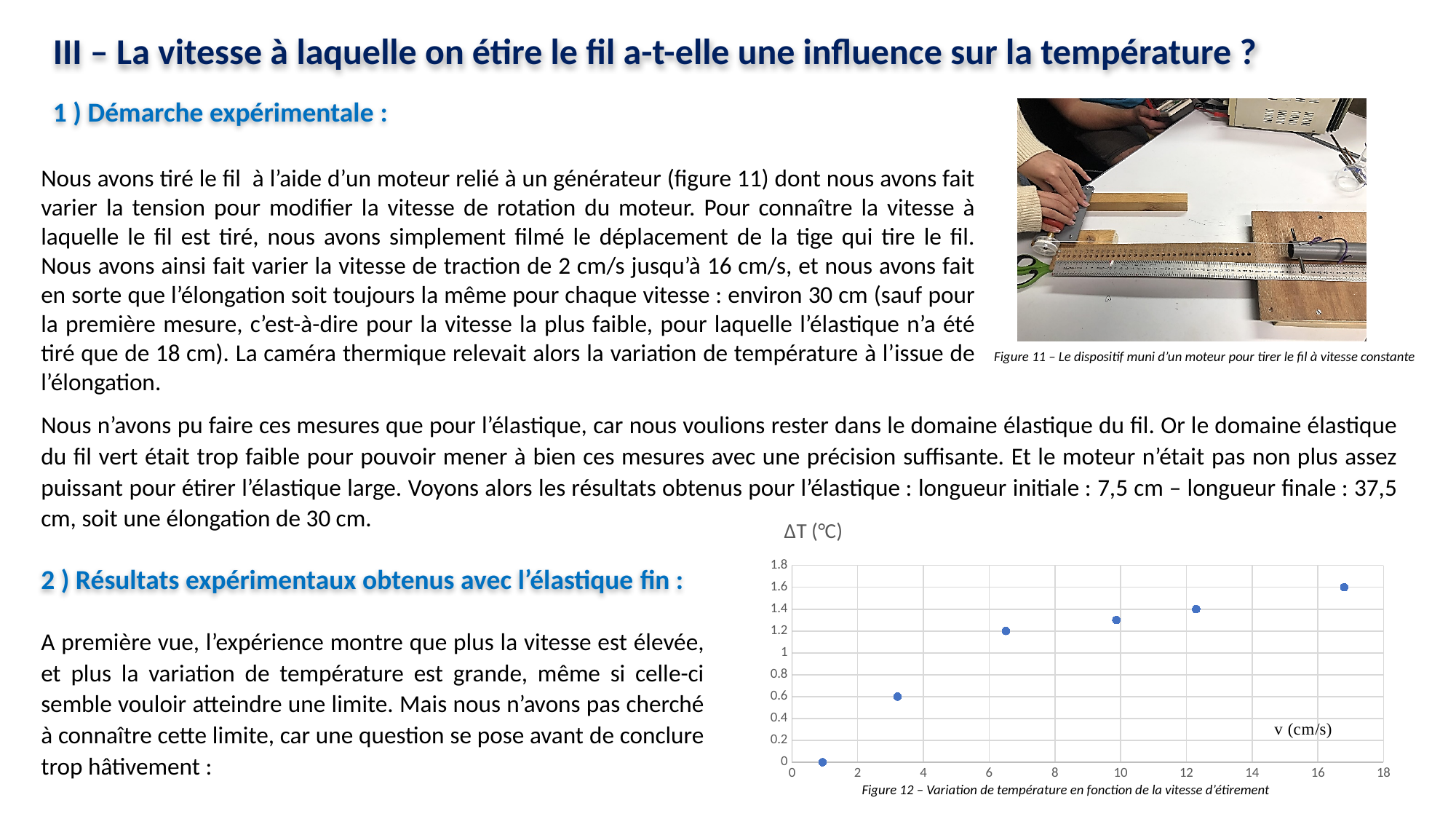
In Figure 12, do the ΔT values rise or fall as v increases along the x axis? rise In Figure 12, which point has a larger ΔT: the point near v = 6 or the point near v = 3? the point near v = 6 In Figure 12, which point has the highest ΔT value: the leftmost or the rightmost? the rightmost What is the label of the y axis in Figure 12? ΔT (°C) In Figure 12, is the v value of the rightmost point greater or less than 16? greater In Figure 12, is the ΔT value of the point near v = 12 greater or less than 1.2? greater How many data points are plotted in Figure 12? 6 What is the label of the x axis in Figure 12? v (cm/s) In Figure 12, is the ΔT value of the second point from the left greater or less than 1? less In Figure 12, what is the highest value shown on the y axis? 1.8 What kind of chart is Figure 12? scatter chart